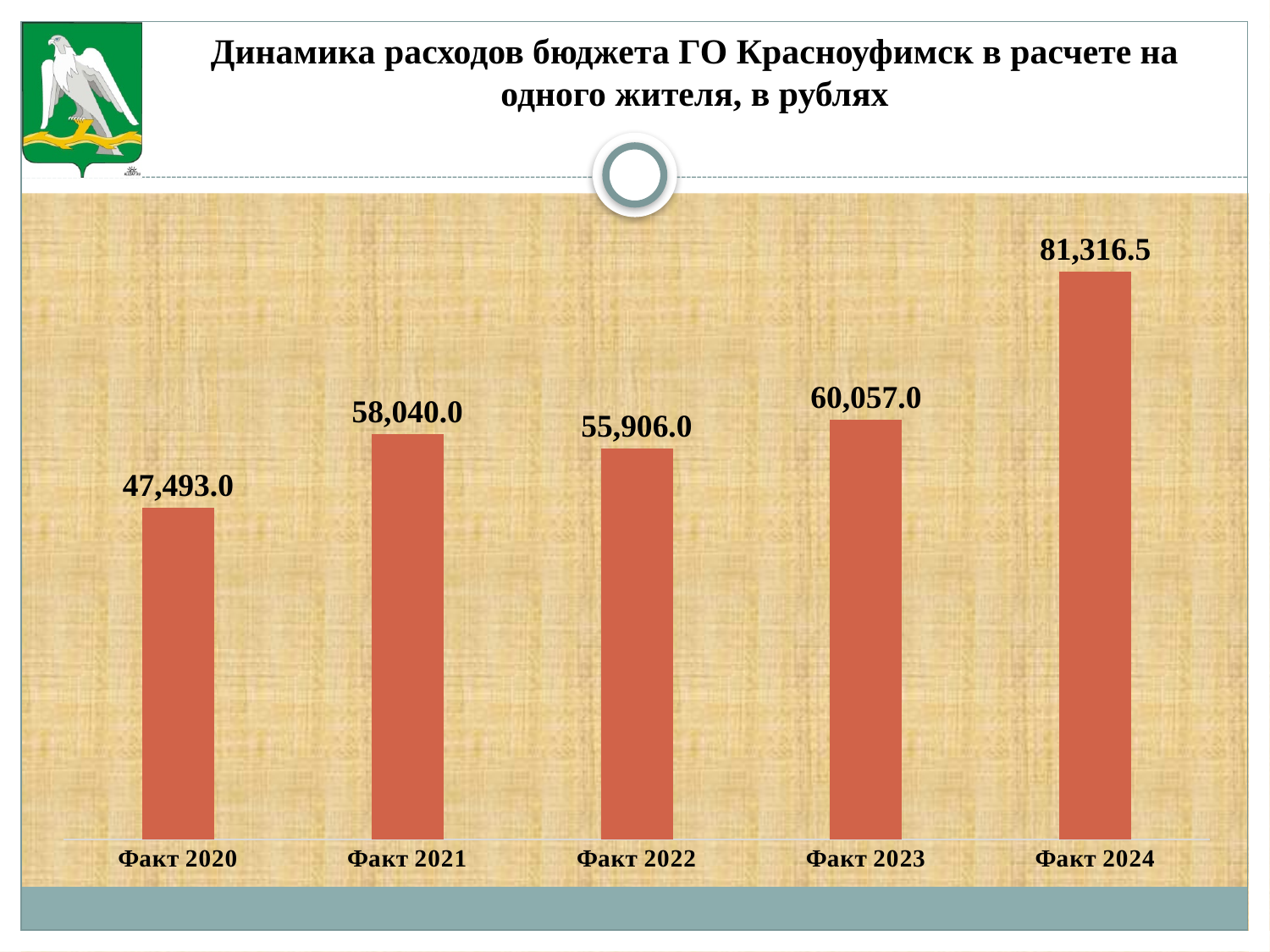
Which category has the lowest value? Факт 2020 Which category has the highest value? Факт 2024 What is the value for Факт 2022? 55,906.0 What kind of chart is shown on the slide? bar chart Which is larger, the value for Факт 2021 or Факт 2022? Факт 2021 What is the value for Факт 2020? 47,493.0 What is the title of the chart? Динамика расходов бюджета ГО Красноуфимск в расчете на одного жителя, в рублях What is the value for Факт 2024? 81,316.5 Does the value rise or fall from Факт 2021 to Факт 2022? fall What is the difference between the values for Факт 2024 and Факт 2023? 21,259.5 How many bars are shown in the chart? 5 What is the difference between the values for Факт 2021 and Факт 2020? 10,547.0